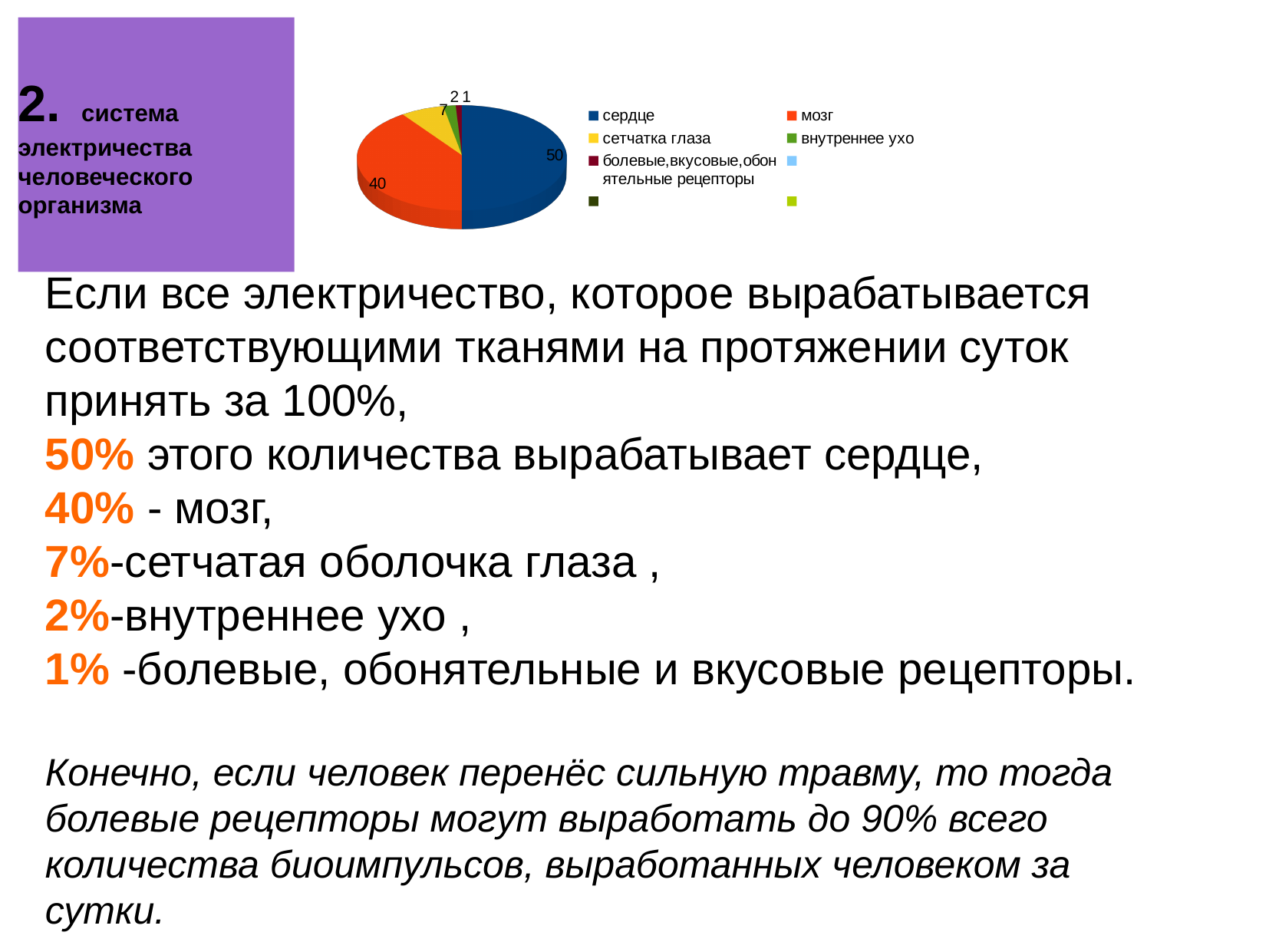
Which category has the smallest slice in the pie chart? болевые, вкусовые, обонятельные рецепторы What kind of chart is shown on the slide? pie chart What value is shown for болевые, вкусовые, обонятельные рецепторы in the pie chart? 1 Which category has the largest slice in the pie chart? сердце What value is shown for сетчатка глаза in the pie chart? 7 What is the difference between the values for сердце and мозг in the pie chart? 10 Which is larger in the pie chart, сетчатка глаза or внутреннее ухо? сетчатка глаза What value is shown for внутреннее ухо in the pie chart? 2 How many slices with data labels does the pie chart have? 5 What colour is the сердце slice in the pie chart? dark blue What value is shown for сердце in the pie chart? 50 What value is shown for мозг in the pie chart? 40